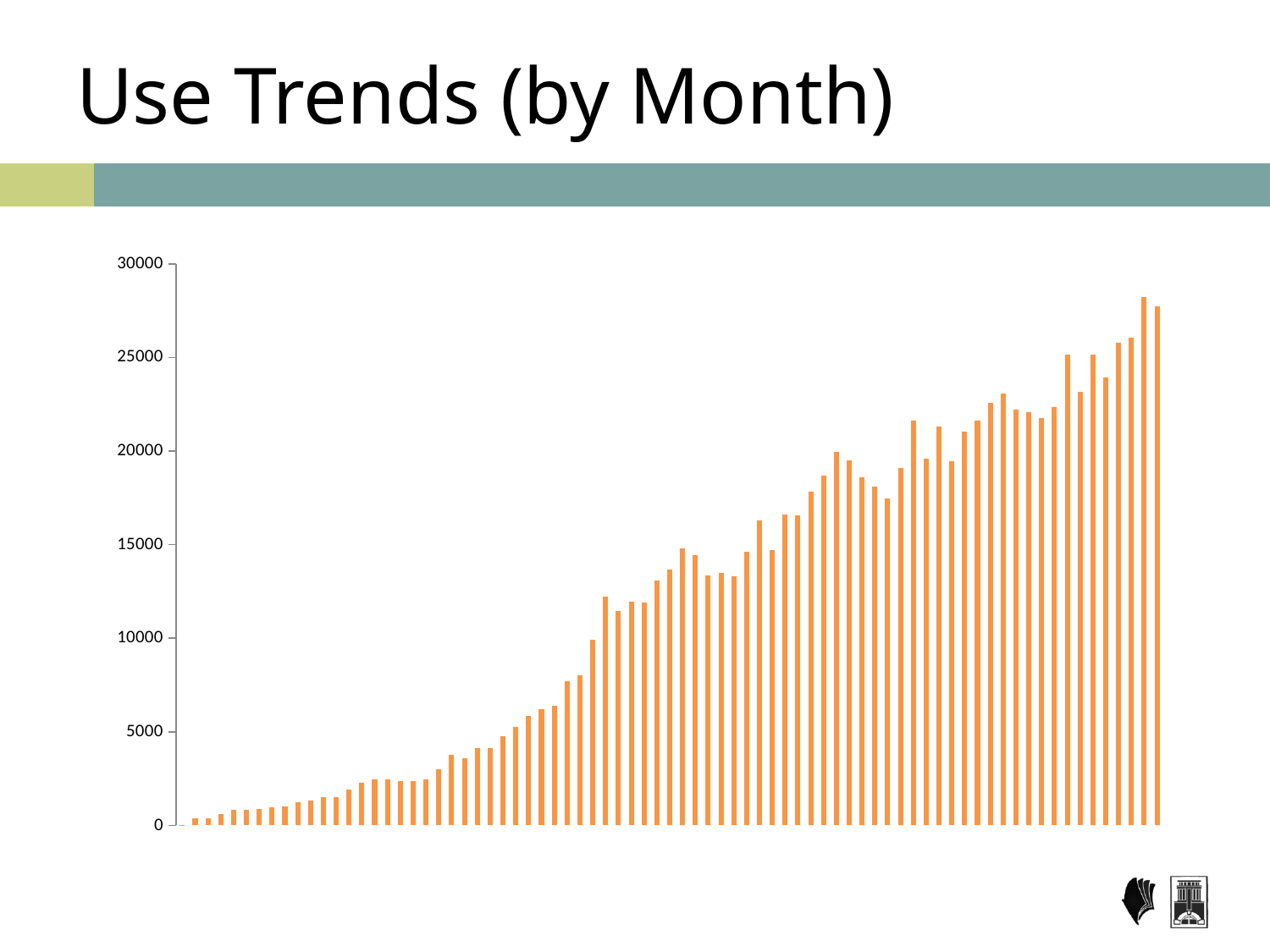
Is the value of the first (leftmost) bar in the chart greater or less than 5000? less Do the values in the chart generally rise or fall from left to right? Rise Is the value of the tallest bar in the chart greater or less than 25000? greater What is the highest value shown on the vertical axis of the chart? 30000 What kind of chart is shown on the slide? Bar chart Is the tallest bar in the chart the rightmost bar? No, it is the second bar from the right Is the value of the tallest bar in the chart greater or less than 30000? less What is the title of the slide containing the chart? Use Trends (by Month) Is the rightmost bar taller or shorter than the bar immediately to its left? Shorter Which bar is the shortest in the chart? The leftmost bar